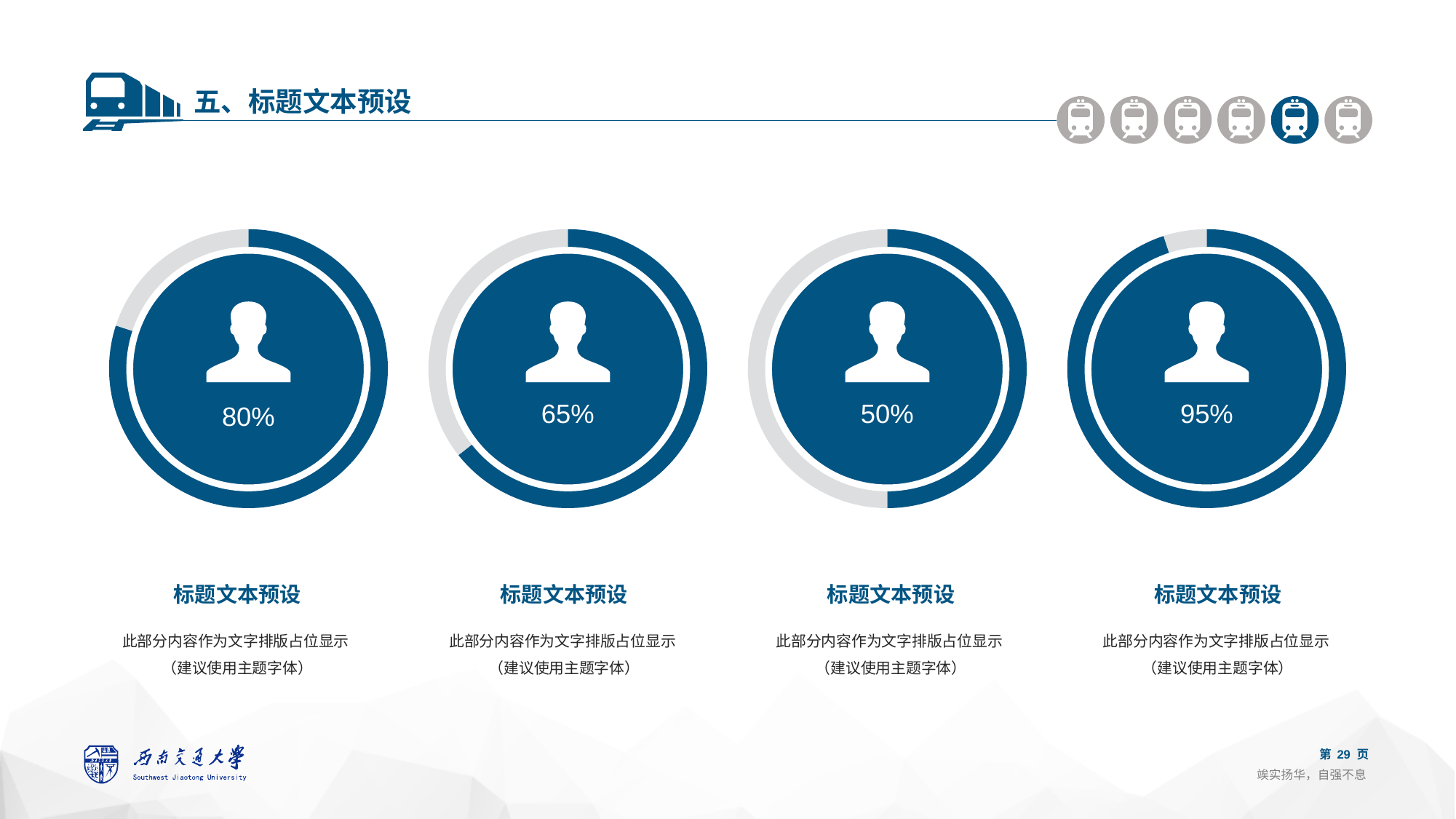
Which is larger, the value in the leftmost ring chart or the value in the second ring chart? The leftmost (80%) What value is shown in the third ring chart from the left? 50% Which ring chart shows the highest percentage? The rightmost one (95%) What value is shown in the rightmost ring chart? 95% What value is shown in the leftmost ring chart? 80% What is the difference between the value in the leftmost ring chart and the value in the third ring chart? 30% What value is shown in the second ring chart from the left? 65% What kind of chart is used to display the percentages on the slide? Ring (donut) progress chart What is the difference between the value in the rightmost ring chart and the value in the leftmost ring chart? 15% Which ring chart shows the lowest percentage? The third from the left (50%) What colour is the filled portion of each ring chart? Dark blue How many ring charts are on the slide? 4